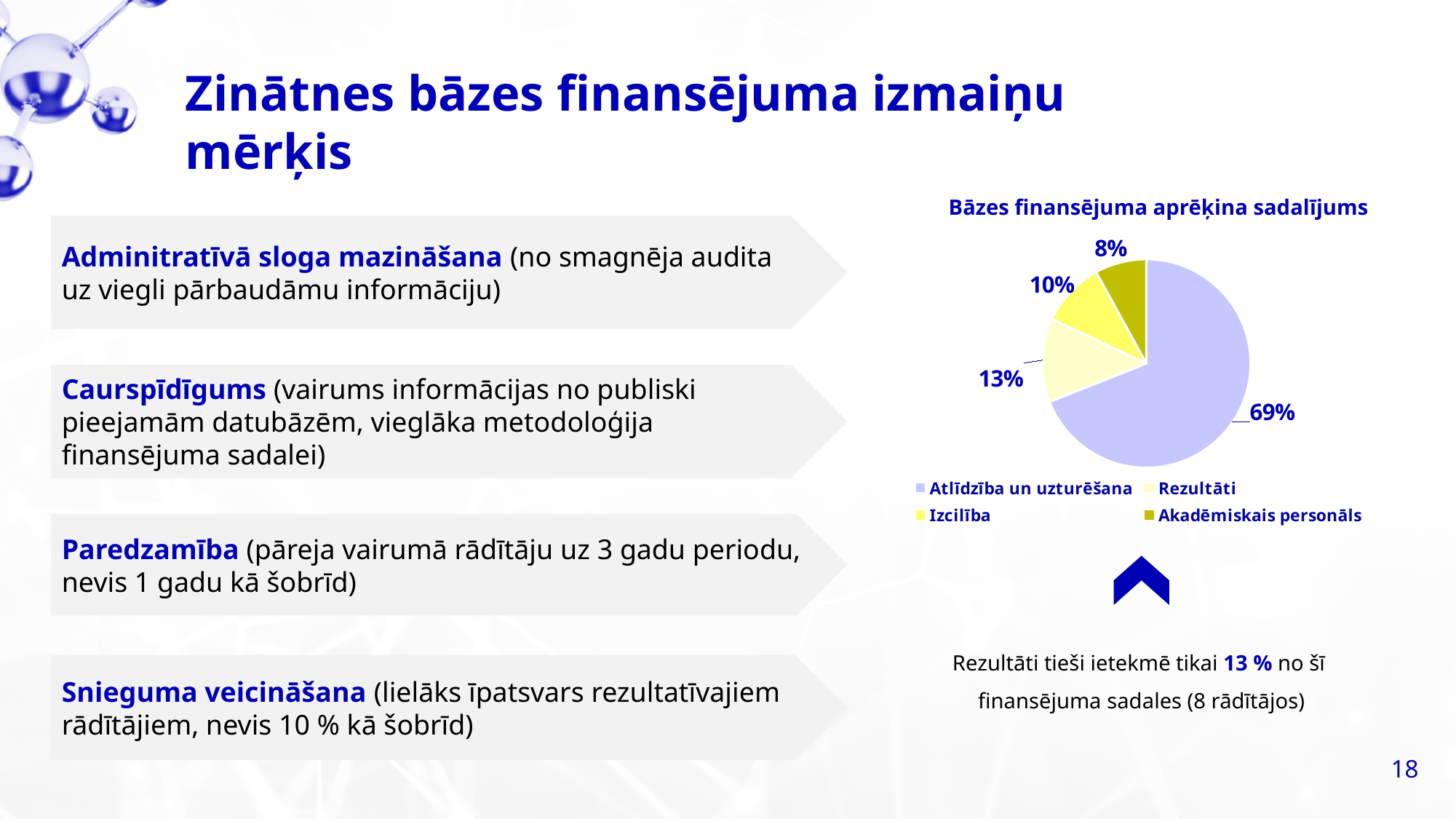
Which category has the smallest slice of the pie? Akadēmiskais personāls What share of the pie does Atlīdzība un uzturēšana have? 69% Which category has the largest slice of the pie? Atlīdzība un uzturēšana What is the difference in percentage points between Atlīdzība un uzturēšana and Rezultāti? 56 How many categories does the pie chart show? 4 What share of the pie does Izcilība have? 10% What is the title of the chart? Bāzes finansējuma aprēķina sadalījums What share of the pie does Akadēmiskais personāls have? 8% What type of chart is shown on the slide? pie chart Which is larger, the share for Izcilība or the share for Akadēmiskais personāls? Izcilība How many entries does the legend list? 4